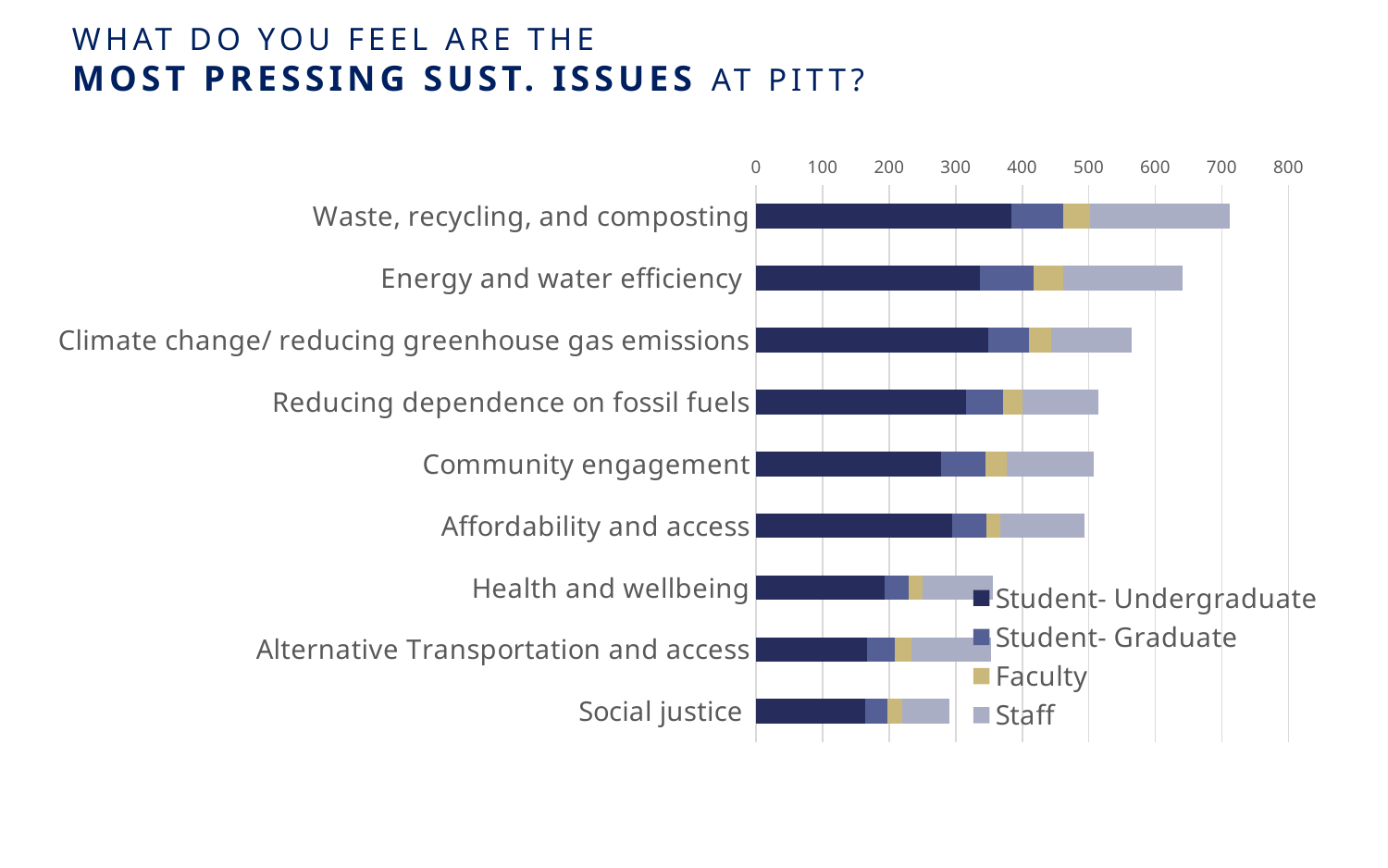
Which issue has the shortest total bar? Social justice What kind of chart is shown on the slide? Stacked bar chart Is the total bar for Social justice greater or less than 400? less Do the total bar lengths increase or decrease going from the top category to the bottom category? decrease Which issue has the longest total bar? Waste, recycling, and composting How many series does the legend list? 4 Which has the larger total bar: Energy and water efficiency or Reducing dependence on fossil fuels? Energy and water efficiency Is the total bar for Energy and water efficiency greater or less than 600? greater How many sustainability issues (categories) are plotted on the chart? 9 Which series is shown in the gold/yellow colour in the legend? Faculty Is the total bar for Waste, recycling, and composting greater or less than 600? greater